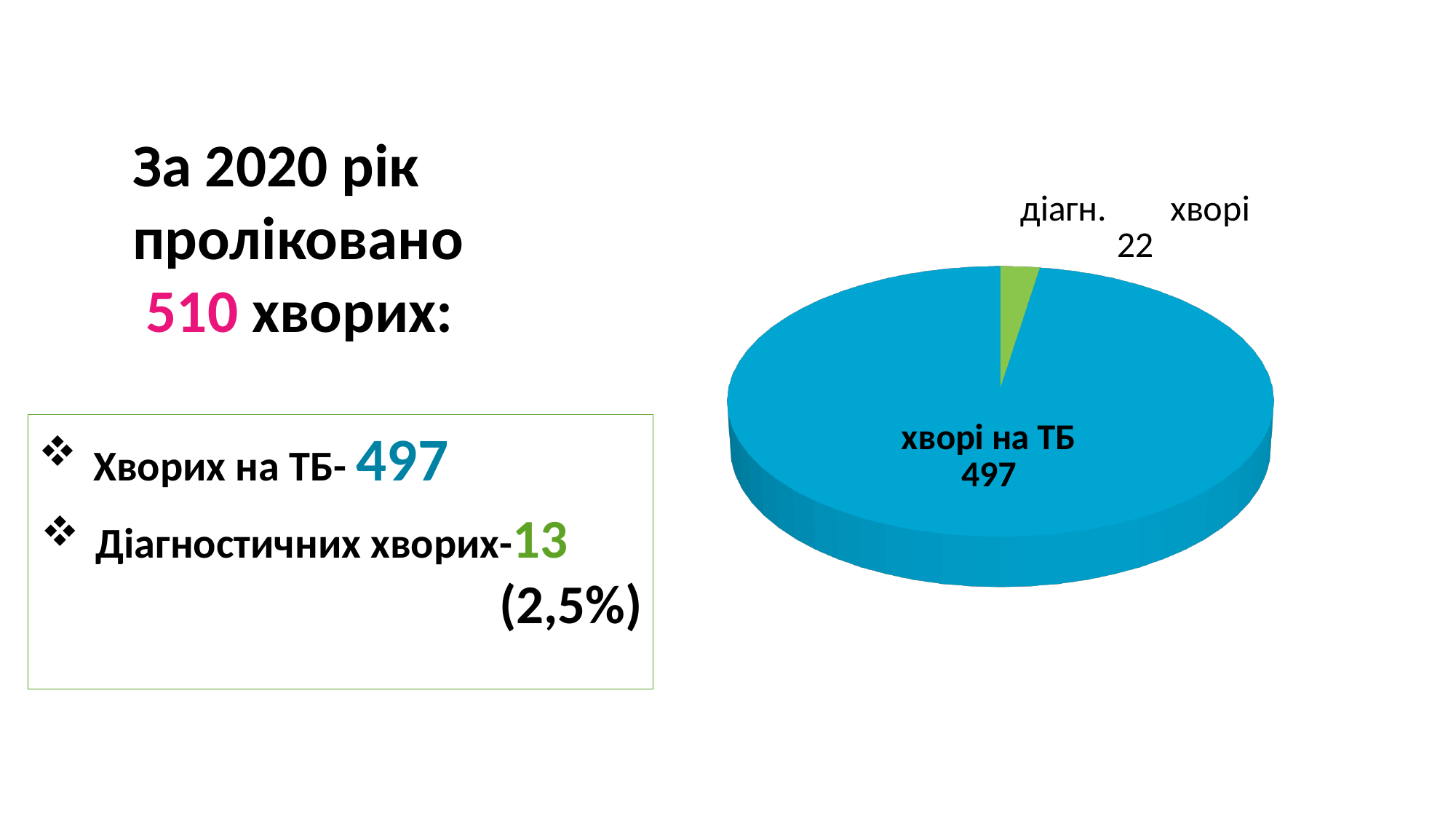
Which slice of the pie chart is the smallest? діагн. хворі What is the value for the "діагн. хворі" slice in the pie chart? 22 What is the value for the "хворі на ТБ" slice in the pie chart? 497 Which slice of the pie chart is the largest? хворі на ТБ What colour is the "діагн. хворі" slice in the pie chart? green What type of chart is shown on the slide? pie chart How many slices does the pie chart have? 2 What colour is the "хворі на ТБ" slice in the pie chart? blue Which is larger in the pie chart: "хворі на ТБ" or "діагн. хворі"? хворі на ТБ What is the difference between the "хворі на ТБ" value and the "діагн. хворі" value in the pie chart? 475